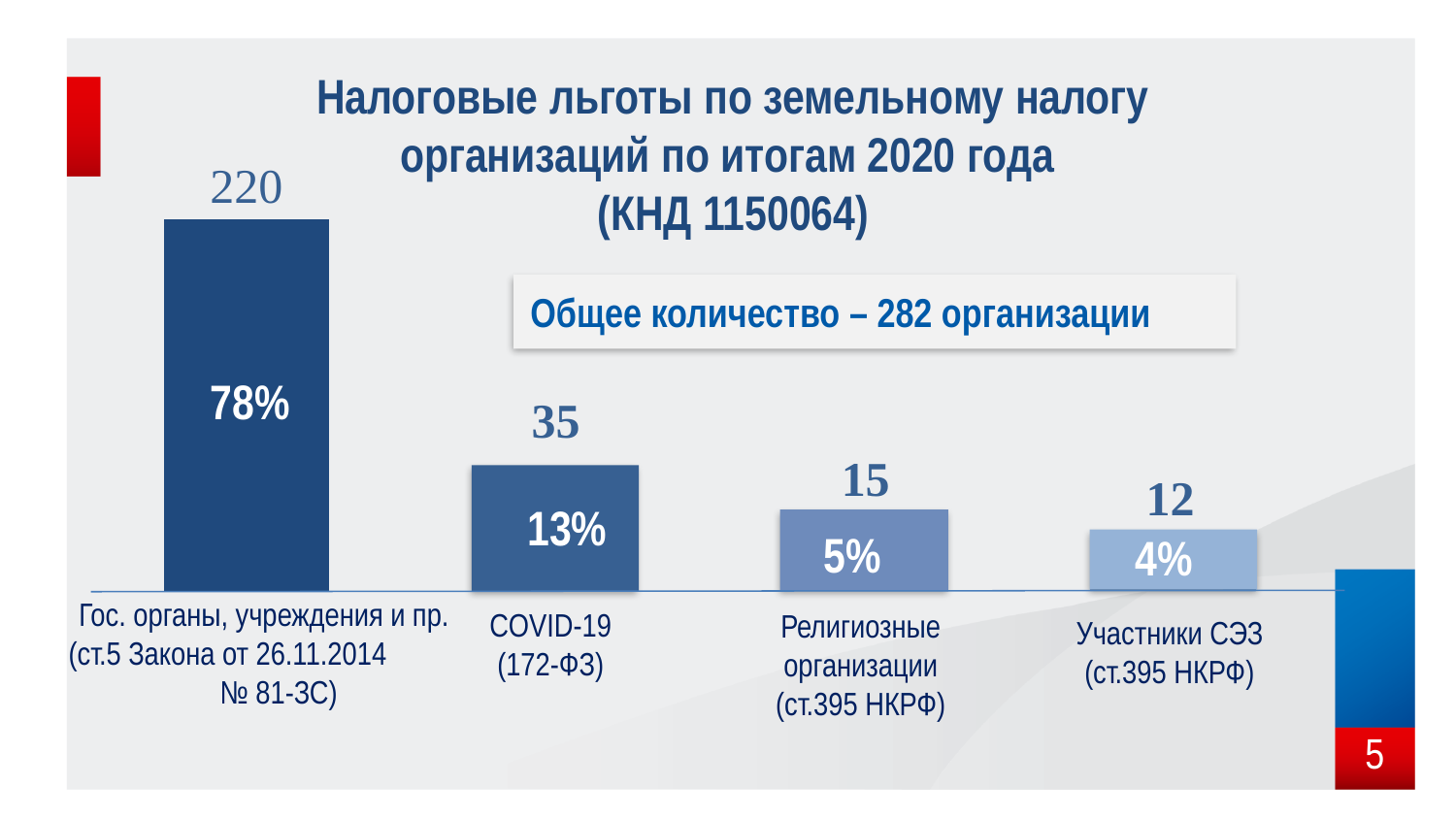
What percentage is shown on the bar for Гос. органы, учреждения и пр.? 78% How many organizations are shown for the COVID-19 (172-ФЗ) category? 35 What is the difference in the number of organizations between Гос. органы, учреждения и пр. and COVID-19 (172-ФЗ)? 185 Which has more organizations: COVID-19 (172-ФЗ) or Религиозные организации (ст.395 НКРФ)? COVID-19 (172-ФЗ) How many organizations are shown for Участники СЭЗ (ст.395 НКРФ)? 12 What total number of organizations is stated on the slide? 282 организации What percentage share is shown on the bar for Религиозные организации (ст.395 НКРФ)? 5% What type of chart is shown on the slide? Bar chart Which category has the lowest number of organizations? Участники СЭЗ (ст.395 НКРФ) How many categories are shown in the chart? 4 Which category has the highest number of organizations? Гос. органы, учреждения и пр. (ст.5 Закона от 26.11.2014 № 81-ЗС) What is the difference in the number of organizations between Религиозные организации and Участники СЭЗ? 3